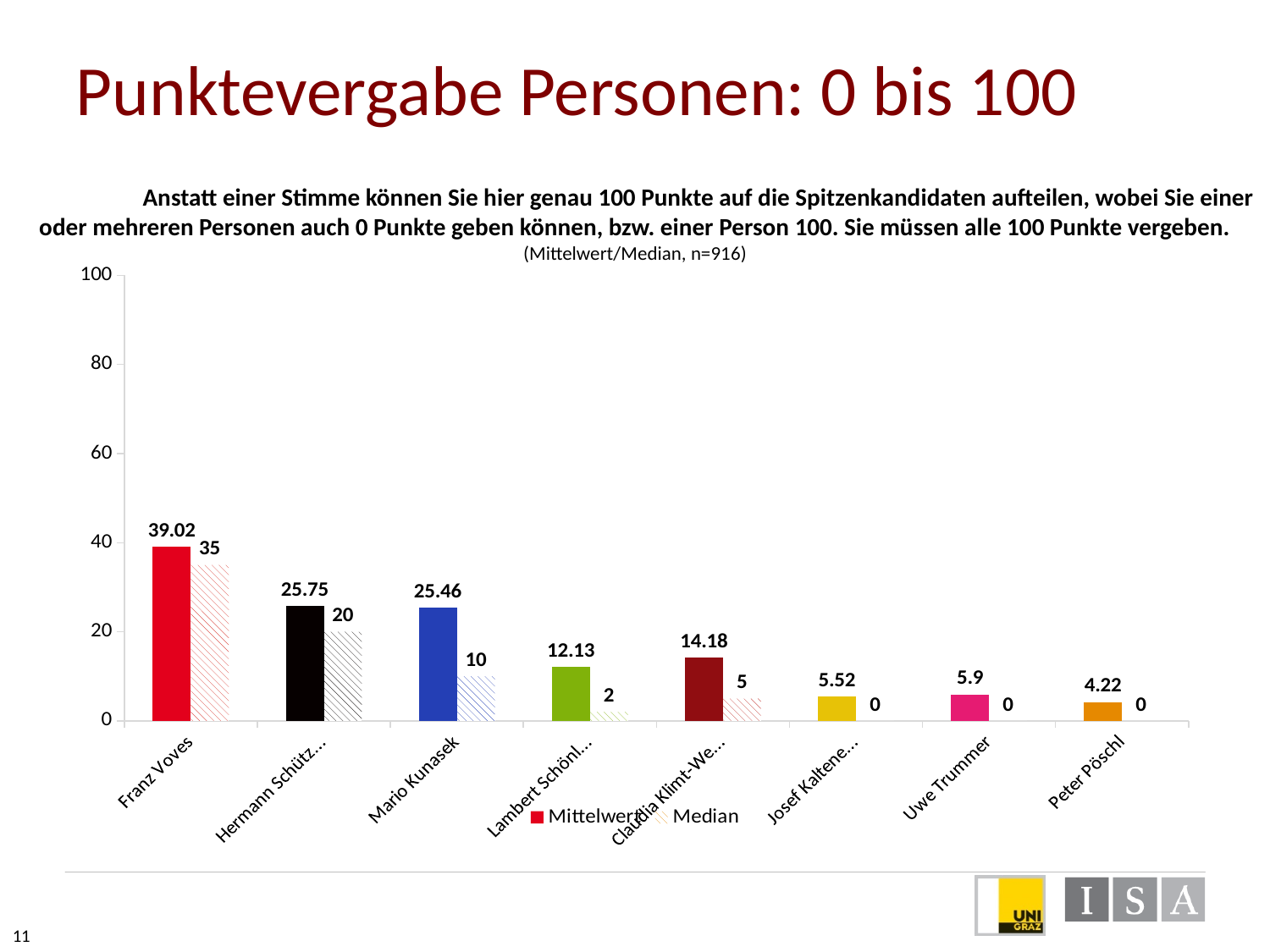
Which has the larger Mittelwert, Uwe Trummer or Peter Pöschl? Uwe Trummer What is the difference between the Mittelwert and the Median for Franz Voves? 4.02 What is the Mittelwert value for Franz Voves? 39.02 What is the difference between the Mittelwert for Franz Voves and the Mittelwert for Mario Kunasek? 13.56 How many series does the legend list? 2 Which candidate has the highest Mittelwert? Franz Voves What is the Median value for Mario Kunasek? 10 Which candidate has the lowest Mittelwert? Peter Pöschl What is the Median value for Uwe Trummer? 0 How many candidates are shown on the x axis of the chart? 8 What kind of chart is shown on the slide? Bar chart How many candidates have a Median value of 0? 3